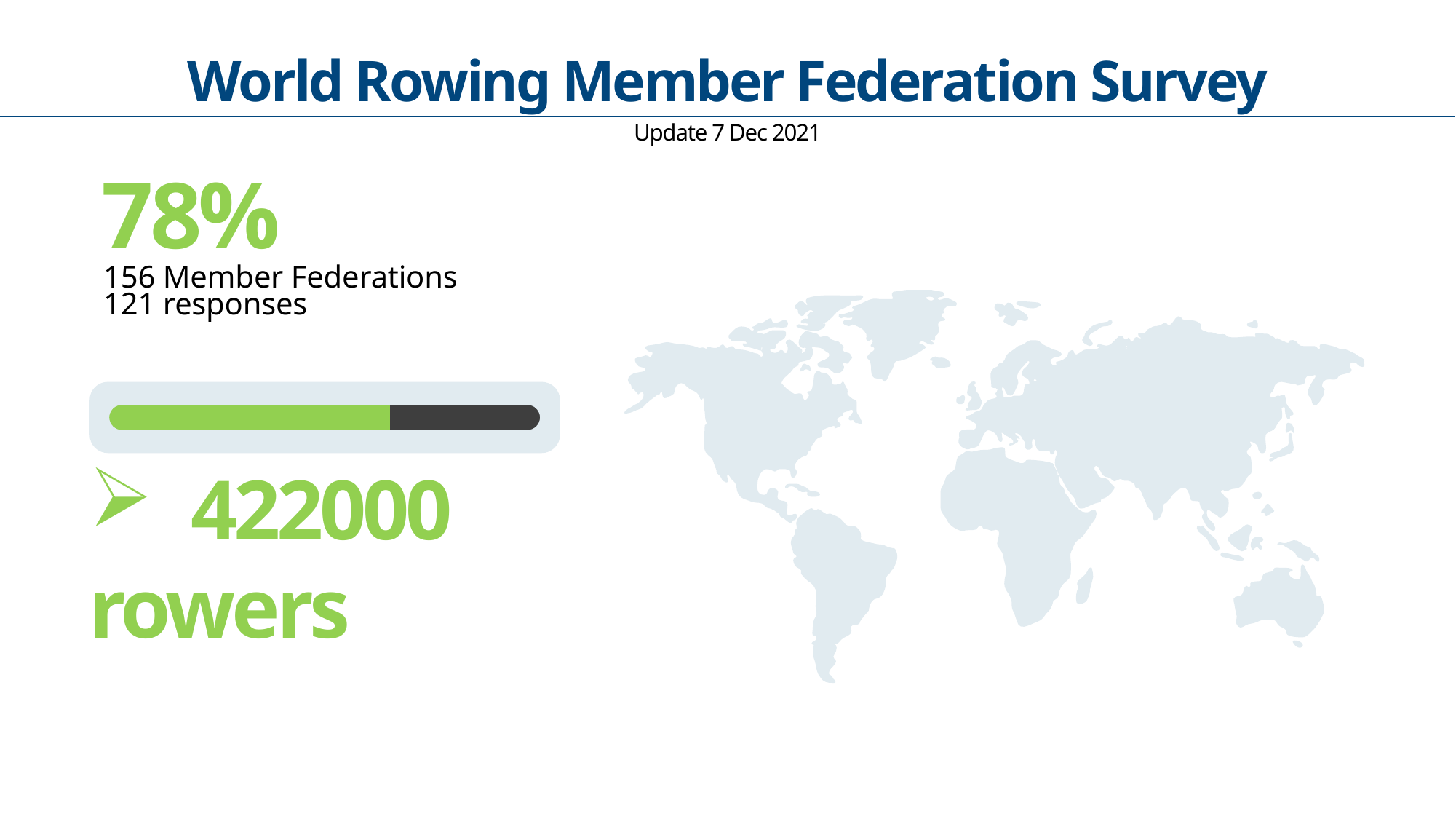
What is the title of the slide containing the progress bar? World Rowing Member Federation Survey How many Member Federations are stated above the progress bar? 156 What colour is the unfilled portion of the progress bar? Dark grey Is the green filled portion of the progress bar greater or less than 50% of the bar? greater Which is larger, the number of Member Federations or the number of responses? Member Federations How many responses are stated above the progress bar? 121 What colour is the filled (completed) portion of the progress bar? Green How many more Member Federations are there than responses? 35 How many rowers are reported below the progress bar? 422000